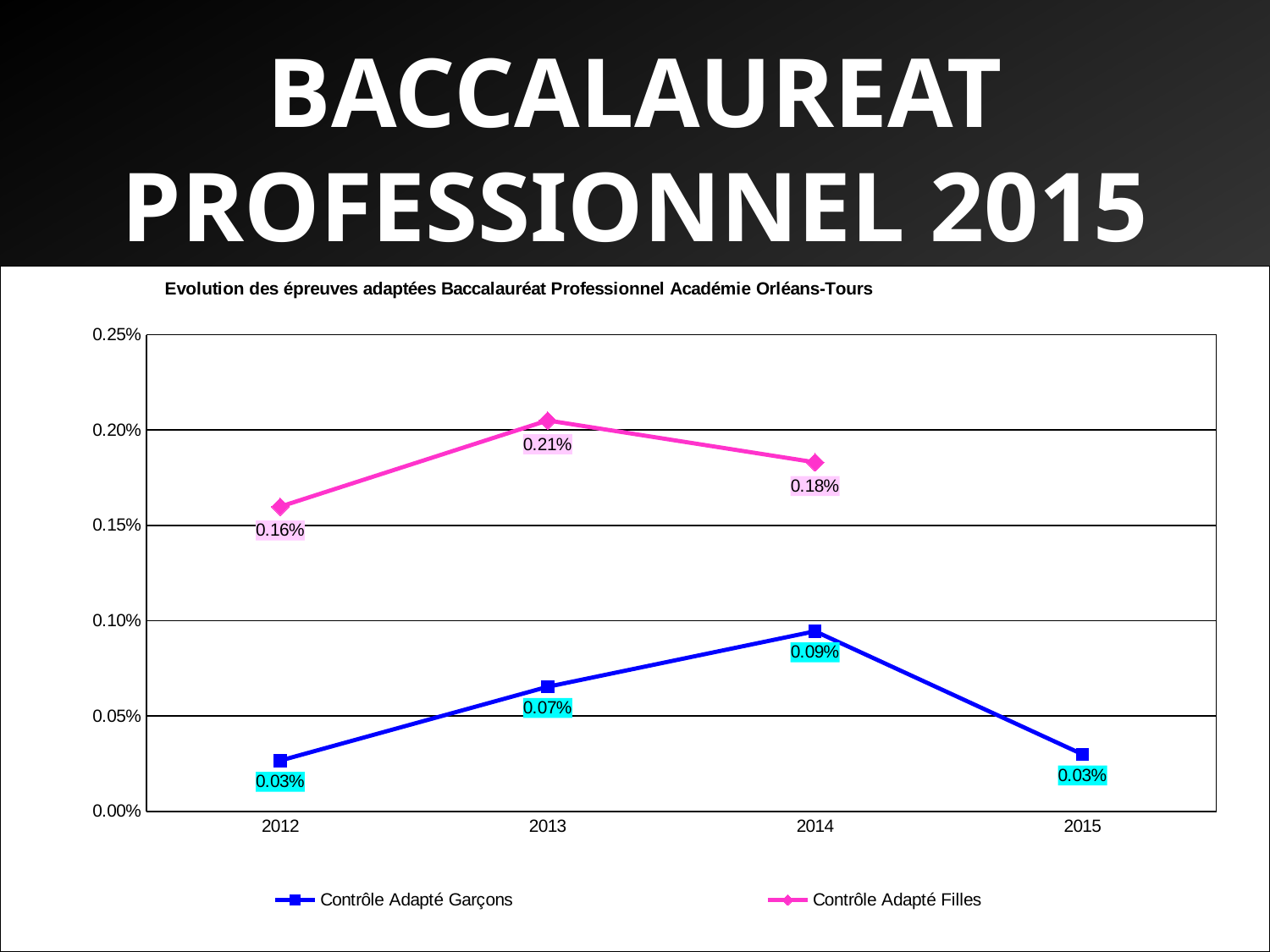
Does the value for Contrôle Adapté Garçons rise or fall from 2014 to 2015? fall What is the value for Contrôle Adapté Garçons in 2014? 0.09% How many years are shown on the x axis? 4 What type of chart is shown on the slide? line chart How many series does the legend list? 2 Which series has the larger value in 2014, Contrôle Adapté Garçons or Contrôle Adapté Filles? Contrôle Adapté Filles What is the value for Contrôle Adapté Filles in 2013? 0.21% What is the value for Contrôle Adapté Filles in 2012? 0.16% What is the difference between Contrôle Adapté Filles and Contrôle Adapté Garçons in 2013? 0.14% In which year is the value for Contrôle Adapté Filles lowest? 2012 In which year is the value for Contrôle Adapté Garçons highest? 2014 Is the value for Contrôle Adapté Filles in 2013 greater or less than 0.20%? greater